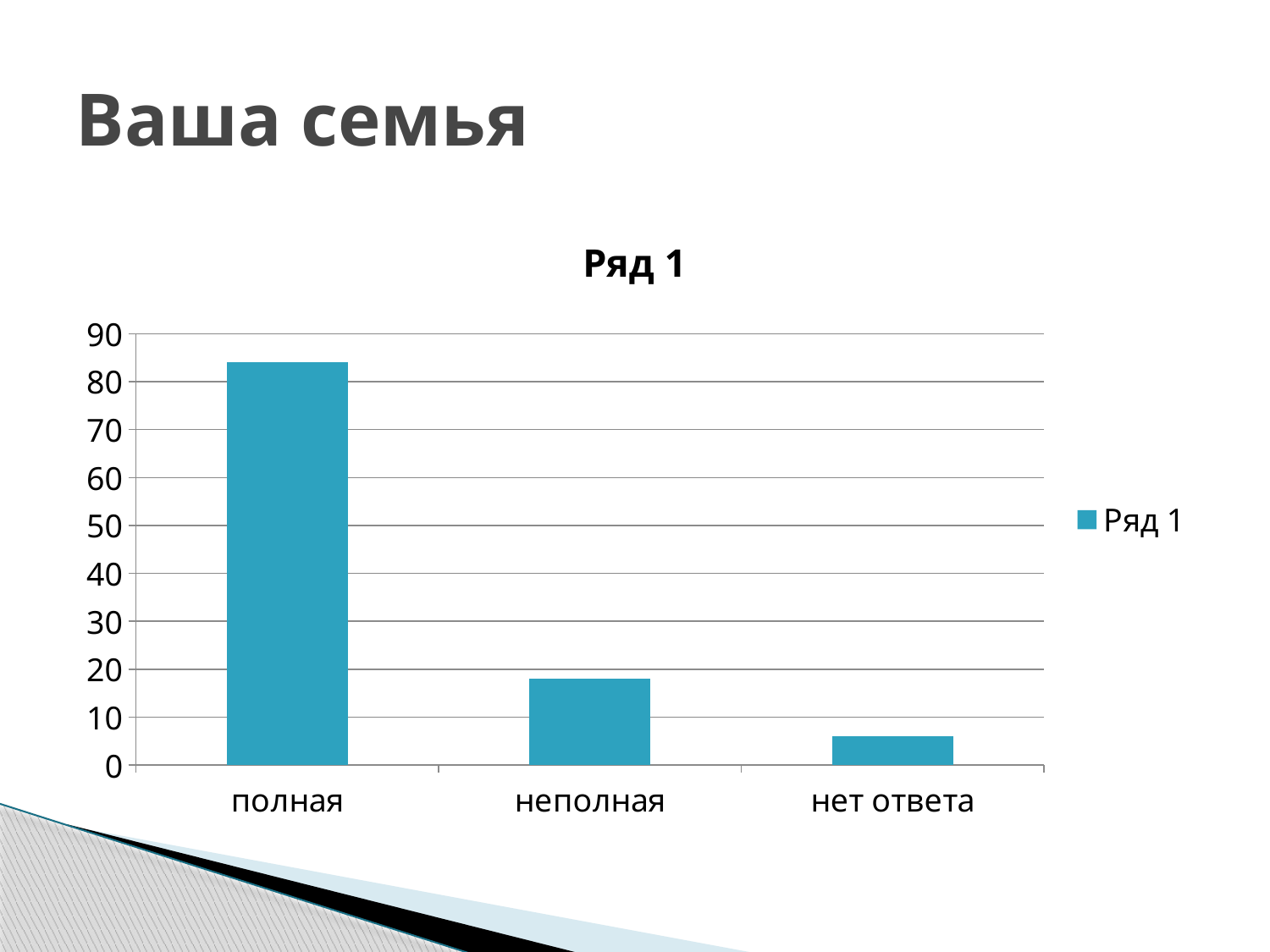
Which is larger, the value for полная or the value for неполная? полная Which category has the lowest value? нет ответа Is the value for нет ответа greater or less than 10? less Do the values rise or fall from left to right along the x axis? fall Which is larger, the value for неполная or the value for нет ответа? неполная Is the value for неполная greater or less than 30? less How many series does the legend list? 1 What kind of chart is shown on the slide? bar chart How many categories are shown on the x axis of the chart? 3 Which category has the highest value? полная Is the value for полная greater or less than 70? greater What is the title of the chart? Ряд 1